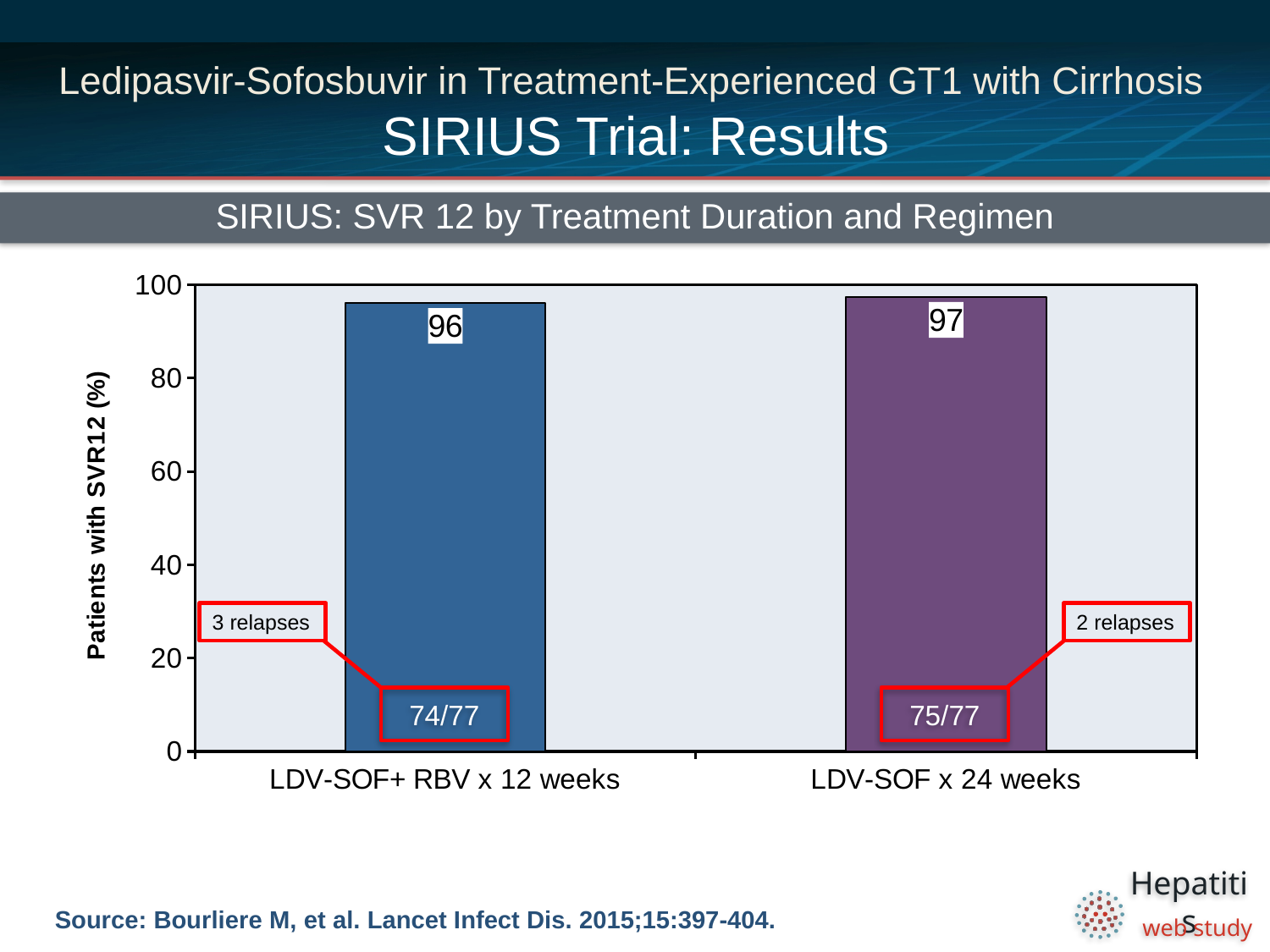
How many patients achieved SVR12 out of the total in the LDV-SOF x 24 weeks arm? 75/77 Which treatment arm has the lower SVR12 rate? LDV-SOF+ RBV x 12 weeks Is the SVR12 rate for LDV-SOF+ RBV x 12 weeks greater or less than 80? greater Which treatment arm has the higher SVR12 rate? LDV-SOF x 24 weeks How many patients achieved SVR12 out of the total in the LDV-SOF+ RBV x 12 weeks arm? 74/77 What is the title of the chart? SIRIUS: SVR 12 by Treatment Duration and Regimen What is the SVR12 rate for LDV-SOF+ RBV x 12 weeks? 96 How many treatment arms are shown in the chart? 2 What kind of chart is shown on the slide? bar chart What is the difference in SVR12 rate between LDV-SOF x 24 weeks and LDV-SOF+ RBV x 12 weeks? 1 What is the SVR12 rate for LDV-SOF x 24 weeks? 97 How many relapses occurred in the LDV-SOF x 24 weeks arm? 2 relapses